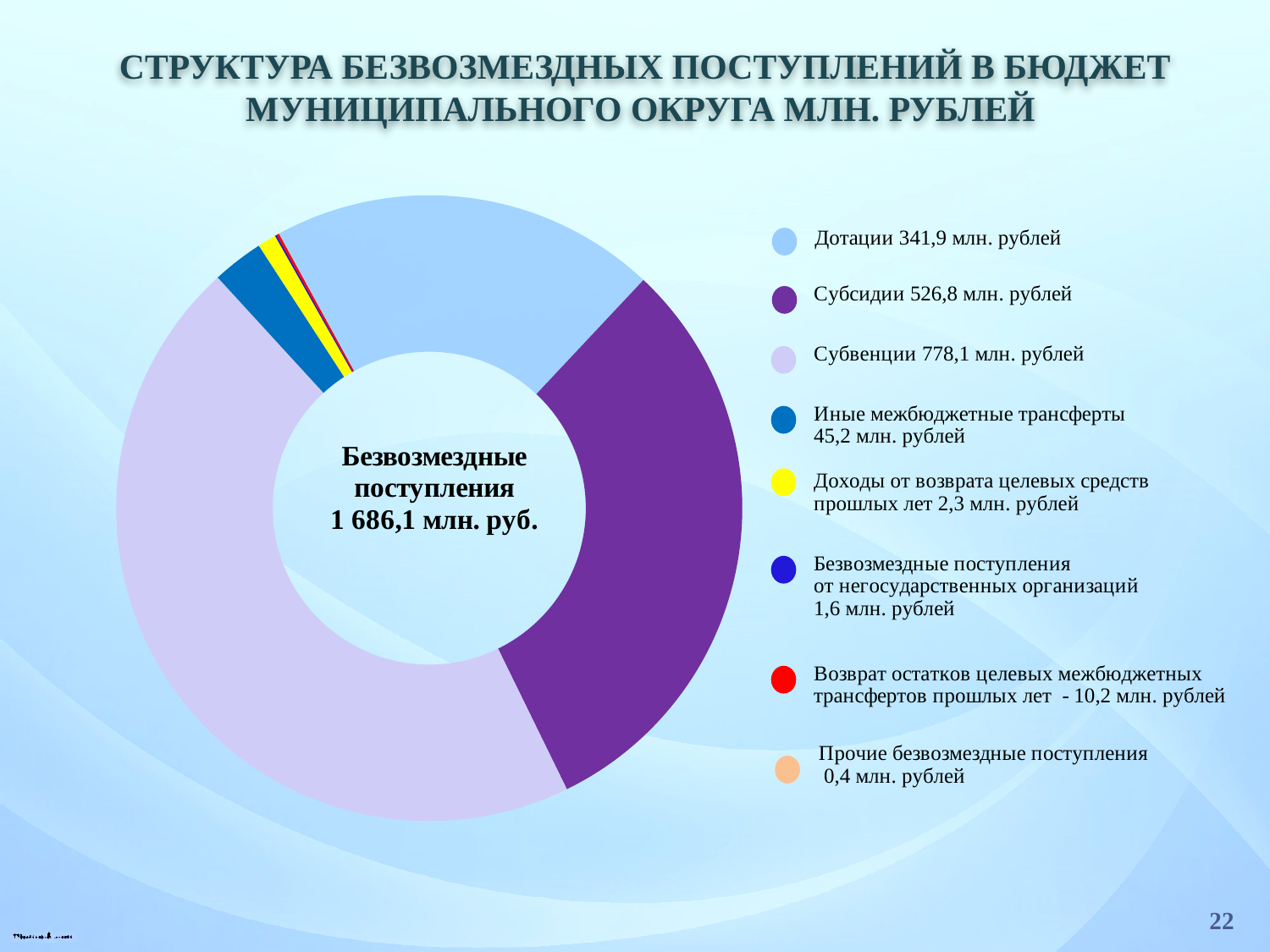
What type of chart is shown on the slide? Doughnut (pie) chart What is the difference between Субвенции and Субсидии? 251,3 млн. рублей What is the value for Прочие безвозмездные поступления? 0,4 млн. рублей What colour represents Субсидии in the chart? Purple What is the value for Иные межбюджетные трансферты? 45,2 млн. рублей Which category has the largest value? Субвенции Which is larger, Дотации or Субсидии? Субсидии Which category has the lowest value? Возврат остатков целевых межбюджетных трансфертов прошлых лет What is the value for Дотации? 341,9 млн. рублей How many categories does the legend list? 8 What is the value for Субсидии? 526,8 млн. рублей What is the total of Безвозмездные поступления shown in the centre of the chart? 1 686,1 млн. руб.